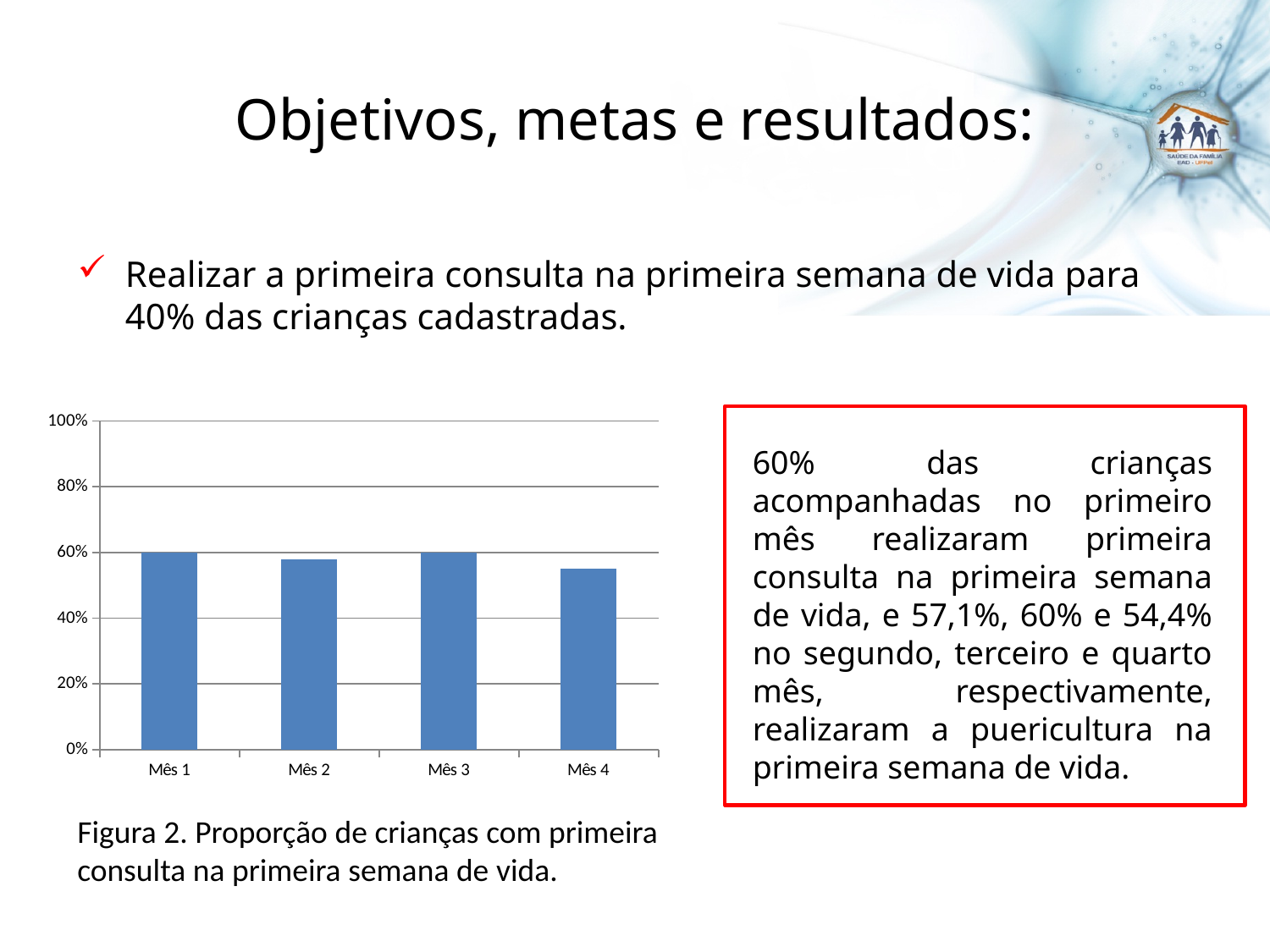
What type of chart is shown on the slide? Bar chart Is the value for Mês 4 greater or less than 60%? less What is the value for Mês 3 in the chart? 60% Is the value for Mês 2 greater or less than 60%? less Is the value for Mês 4 higher or lower than the value for Mês 1? lower Is the value for Mês 4 greater or less than 40%? greater What is the value for Mês 1 in the chart? 60% How many categories (months) are shown on the x axis of the chart? 4 Which is larger, the value for Mês 2 or the value for Mês 4? Mês 2 Which is larger, the value for Mês 1 or the value for Mês 4? Mês 1 What is the figure caption given below the chart? Figura 2. Proporção de crianças com primeira consulta na primeira semana de vida. Which month has the lowest value in the chart? Mês 4